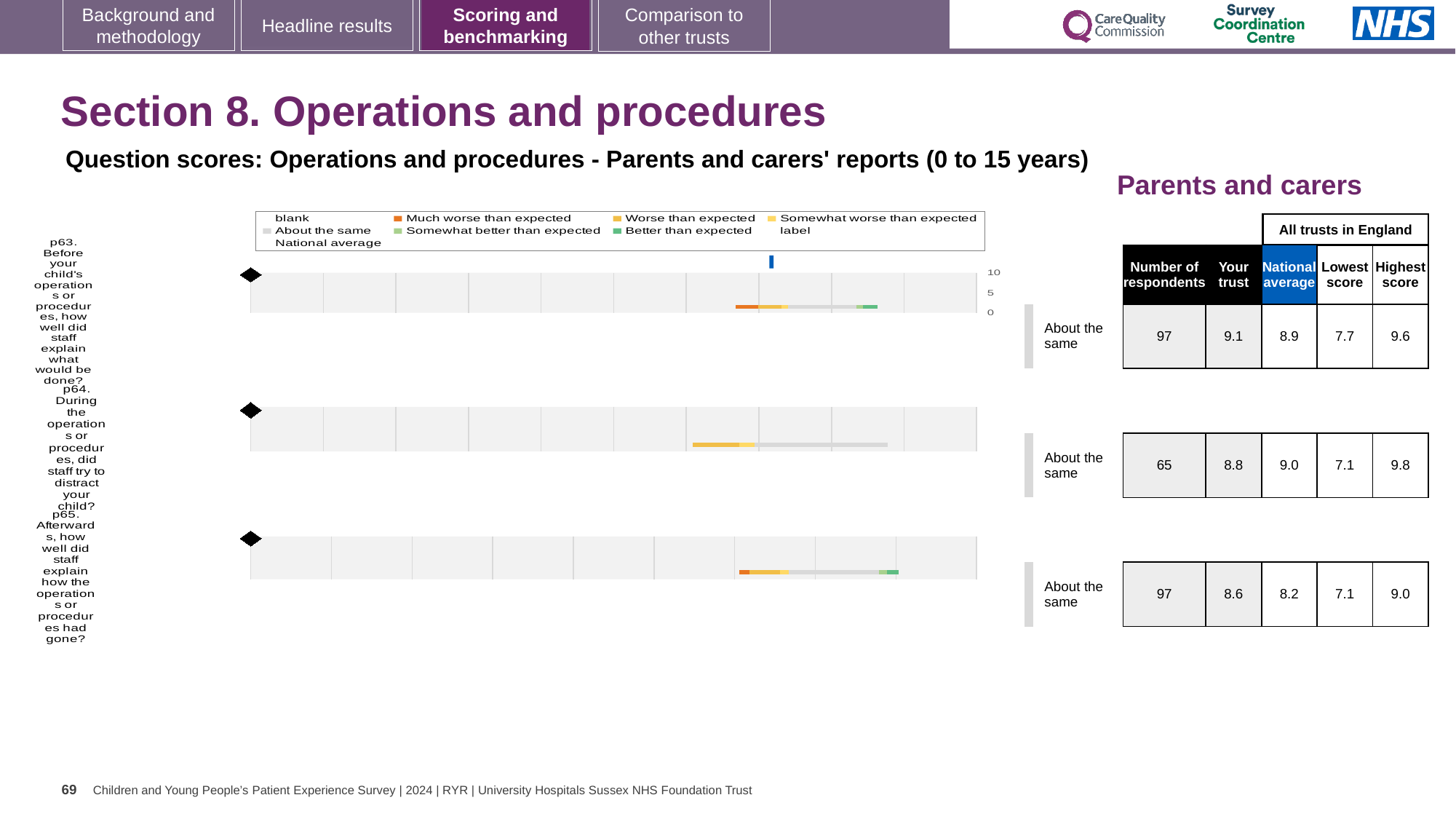
How many respondents answered p64? 65 What is the difference between the 'Your trust' score and the national average for p63? 0.2 What is the highest score across all trusts in England for p65 (how well staff explained how the operation had gone)? 9.0 How many entries does the chart legend list? 9 For p64, which is larger: the 'Your trust' score or the national average? National average What kind of chart is shown on the slide? bar chart Which question has the highest 'Your trust' score? p63 Which question has the lowest 'Your trust' score? p65 What benchmark category is shown for all three questions? About the same How many questions (bars) are plotted in the chart? 3 What is the national average score for p64 (did staff try to distract your child during the operation)? 9.0 What is the 'Your trust' score for p63 (how well staff explained what would be done before the operation)? 9.1